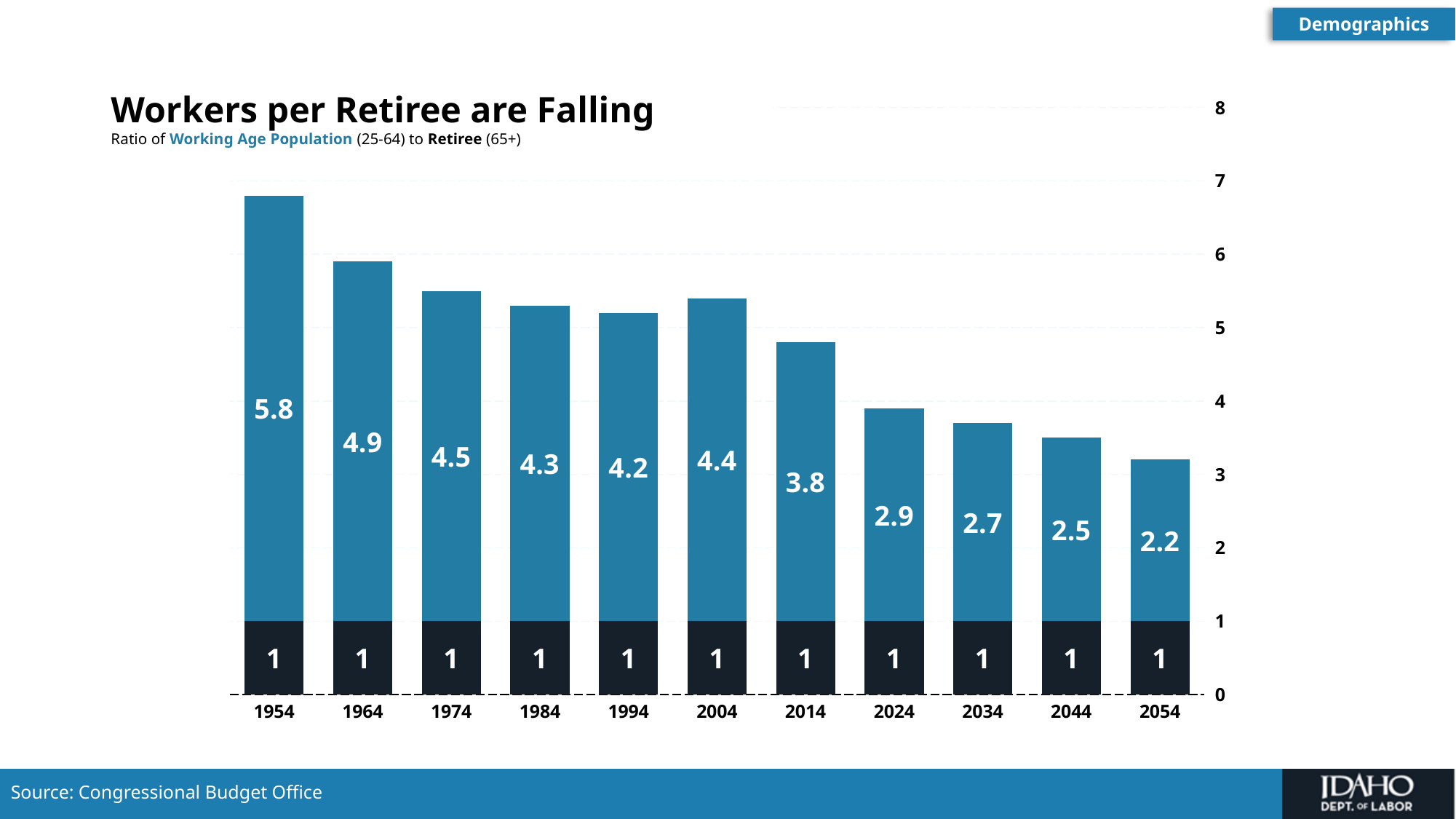
What is the total height of the stacked bar for 2014? 4.8 What is the title of the chart? Workers per Retiree are Falling What kind of chart is shown on the slide? Stacked bar chart What is the working age population value for 1954? 5.8 What is the working age population value for 2024? 2.9 What is the difference between the working age population values for 1954 and 2054? 3.6 Do the working age population values generally rise or fall from 1954 to 2054? Fall Which year has a larger working age population value, 1994 or 2004? 2004 How many years are shown on the x axis? 11 Which year has the highest working age population value? 1954 What is the retiree value shown for 2054? 1 Which year has the lowest working age population value? 2054